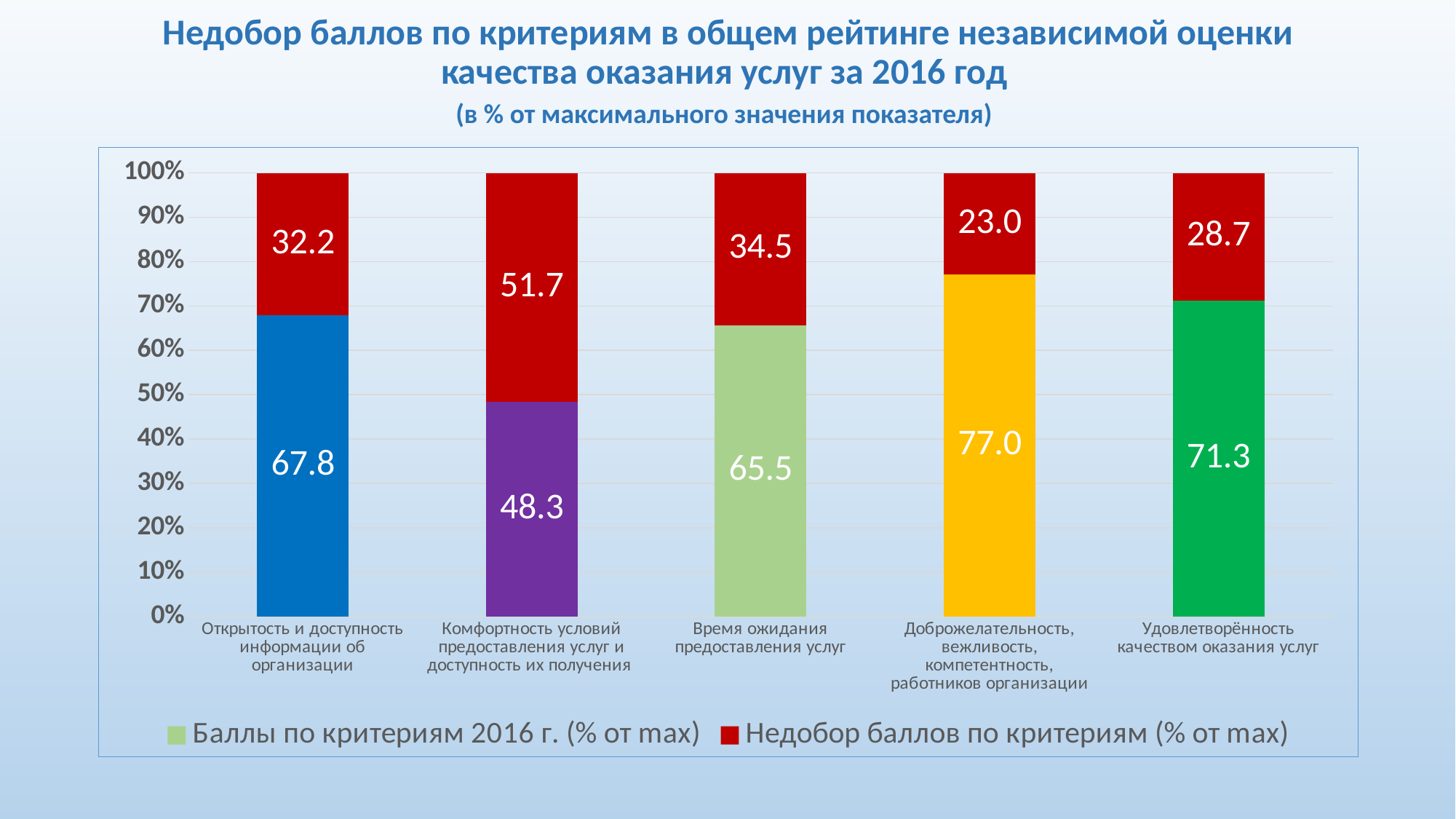
What is the value of "Баллы по критериям 2016 г. (% от max)" for "Удовлетворённость качеством оказания услуг"? 71.3 How many categories are shown on the x axis? 5 Which category has the highest value of "Баллы по критериям 2016 г. (% от max)"? Доброжелательность, вежливость, компетентность, работников организации What is the value of "Баллы по критериям 2016 г. (% от max)" for "Время ожидания предоставления услуг"? 65.5 What is the value of "Недобор баллов по критериям (% от max)" for "Комфортность условий предоставления услуг и доступность их получения"? 51.7 Which is larger: the "Баллы по критериям 2016 г. (% от max)" value for "Открытость и доступность информации об организации" or for "Удовлетворённость качеством оказания услуг"? Удовлетворённость качеством оказания услуг Which category has the highest value of "Недобор баллов по критериям (% от max)"? Комфортность условий предоставления услуг и доступность их получения What is the total of the stacked bar for "Доброжелательность, вежливость, компетентность, работников организации"? 100.0 Which category has the lowest value of "Недобор баллов по критериям (% от max)"? Доброжелательность, вежливость, компетентность, работников организации What is the difference between the "Недобор баллов по критериям (% от max)" values for "Время ожидания предоставления услуг" and "Открытость и доступность информации об организации"? 2.3 How many series does the legend list? 2 What kind of chart is shown on the slide? Stacked bar chart